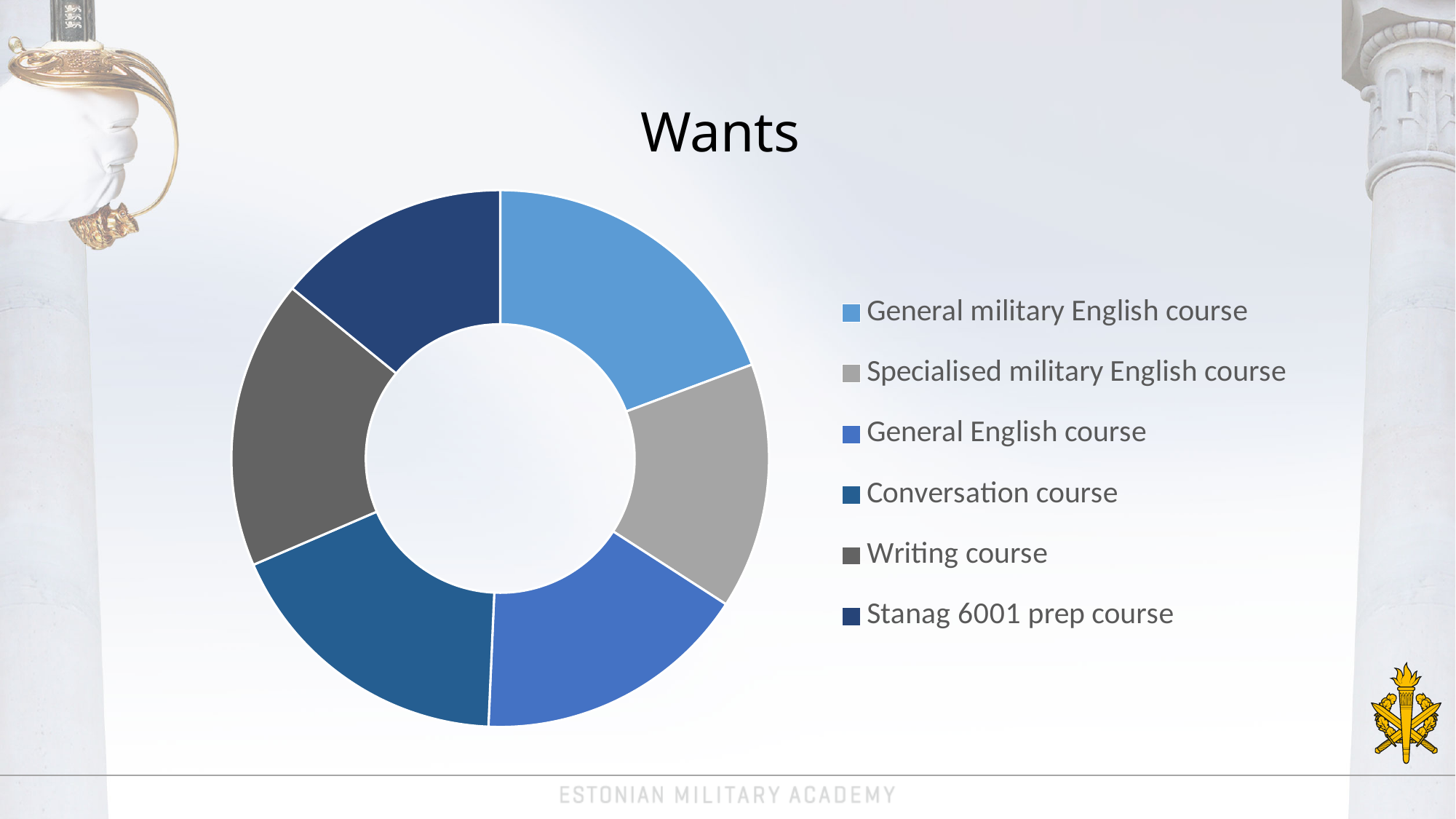
Which slice is larger: General military English course or Stanag 6001 prep course? General military English course What kind of chart is shown on the slide? Doughnut (pie) chart Which slice is larger: General military English course or Specialised military English course? General military English course How many categories does the chart show? 6 How many entries does the legend list? 6 Which category is listed last in the legend? Stanag 6001 prep course What is the title of the chart? Wants Which slice is larger: Conversation course or Stanag 6001 prep course? Conversation course